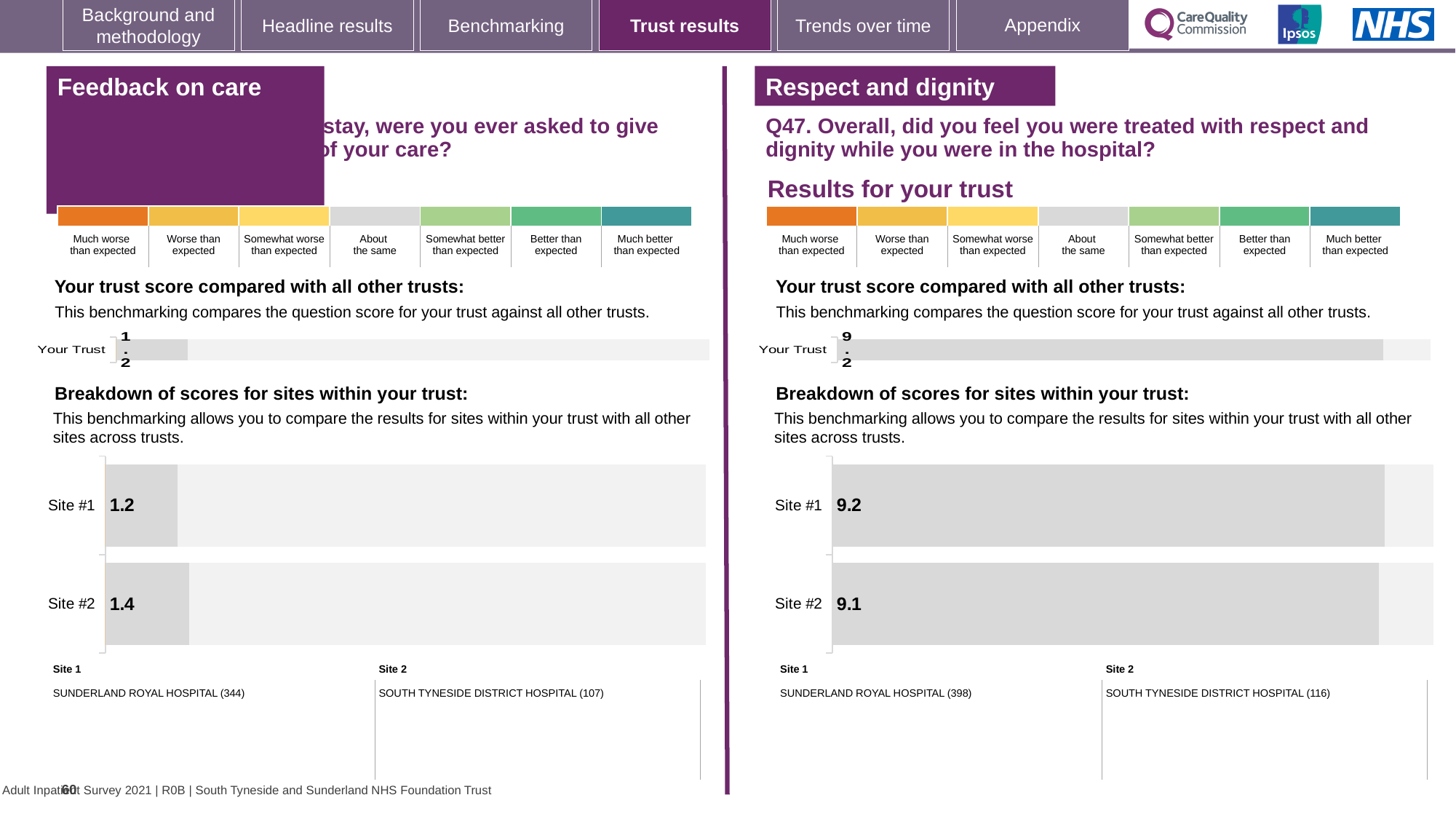
In the 'Respect and dignity' site breakdown chart, what is the score for Site #2? 9.1 In the 'Feedback on care' site breakdown chart, what is the score for Site #2? 1.4 In the 'Feedback on care' site breakdown chart, what is the score for Site #1? 1.2 In the 'Respect and dignity' section, what is the trust score shown for Your Trust? 9.2 In the 'Respect and dignity' site breakdown chart, what is the difference between the scores for Site #1 and Site #2? 0.1 In the 'Respect and dignity' site breakdown chart, what is the score for Site #1? 9.2 In the 'Feedback on care' site breakdown chart, which site has the higher score? Site #2 In the 'Respect and dignity' site breakdown chart, which site has the lower score? Site #2 In the 'Feedback on care' section, what is the trust score shown for Your Trust? 1.2 In the 'Feedback on care' site breakdown chart, what is the difference between the scores for Site #2 and Site #1? 0.2 What type of chart is used for the site breakdown in the 'Respect and dignity' section? Bar chart How many sites are shown in the 'Feedback on care' site breakdown chart? 2